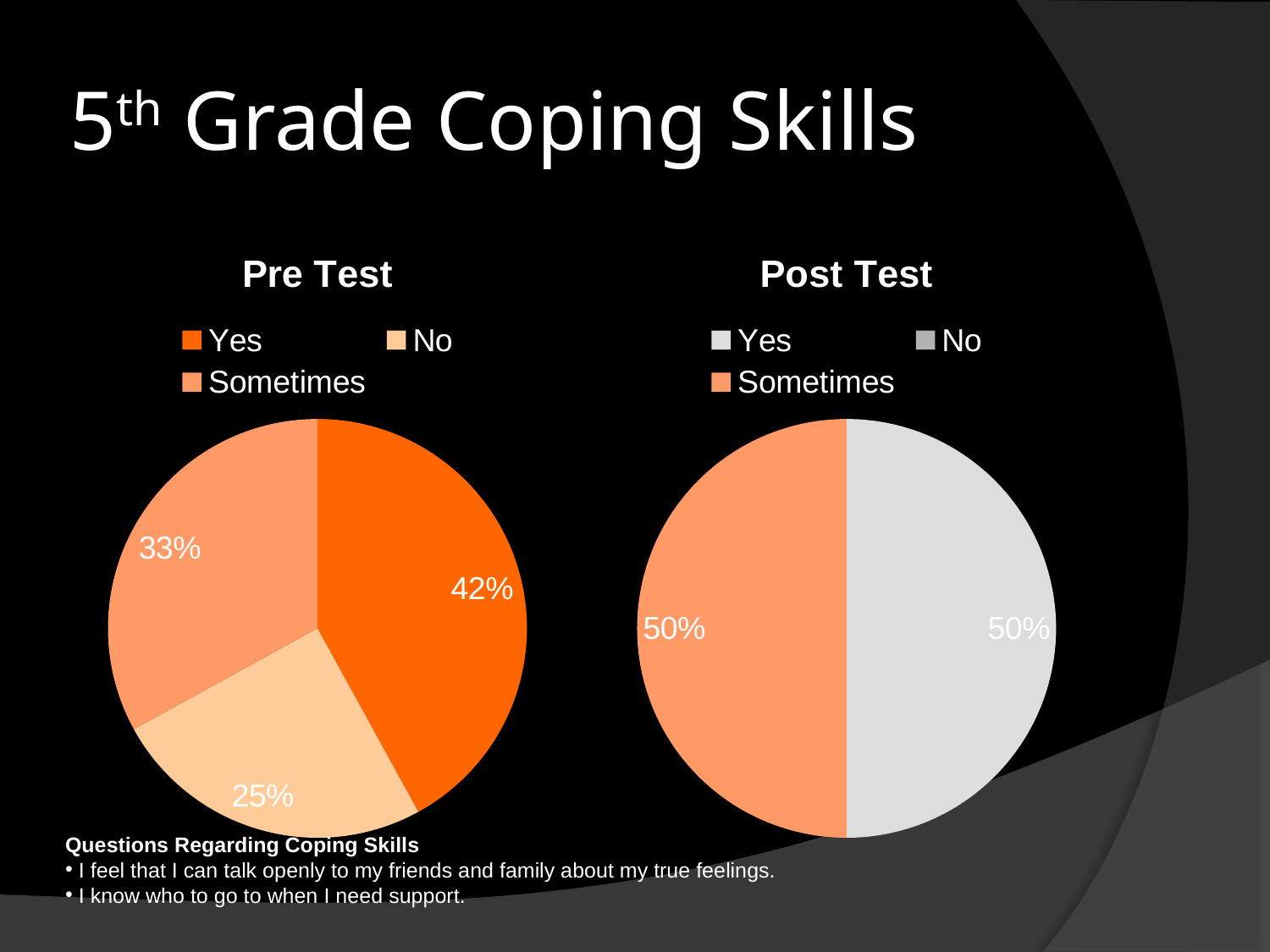
What type of chart is the Post Test chart? Pie chart In the Pre Test chart, what percentage of responses were Yes? 42% In the Pre Test chart, which response has the largest share? Yes In the Pre Test chart, which response has the smallest share? No In the Pre Test chart, which is larger, the Sometimes share or the No share? Sometimes In the Pre Test chart, what percentage of responses were No? 25% In the Post Test chart, what colour is the Sometimes slice? Orange How many entries does the legend of the Pre Test chart list? 3 In the Post Test chart, what percentage of responses were Yes? 50% In the Post Test chart, what percentage of responses were Sometimes? 50% In the Pre Test chart, what is the difference between the Yes and No shares? 17% In the Pre Test chart, what percentage of responses were Sometimes? 33%